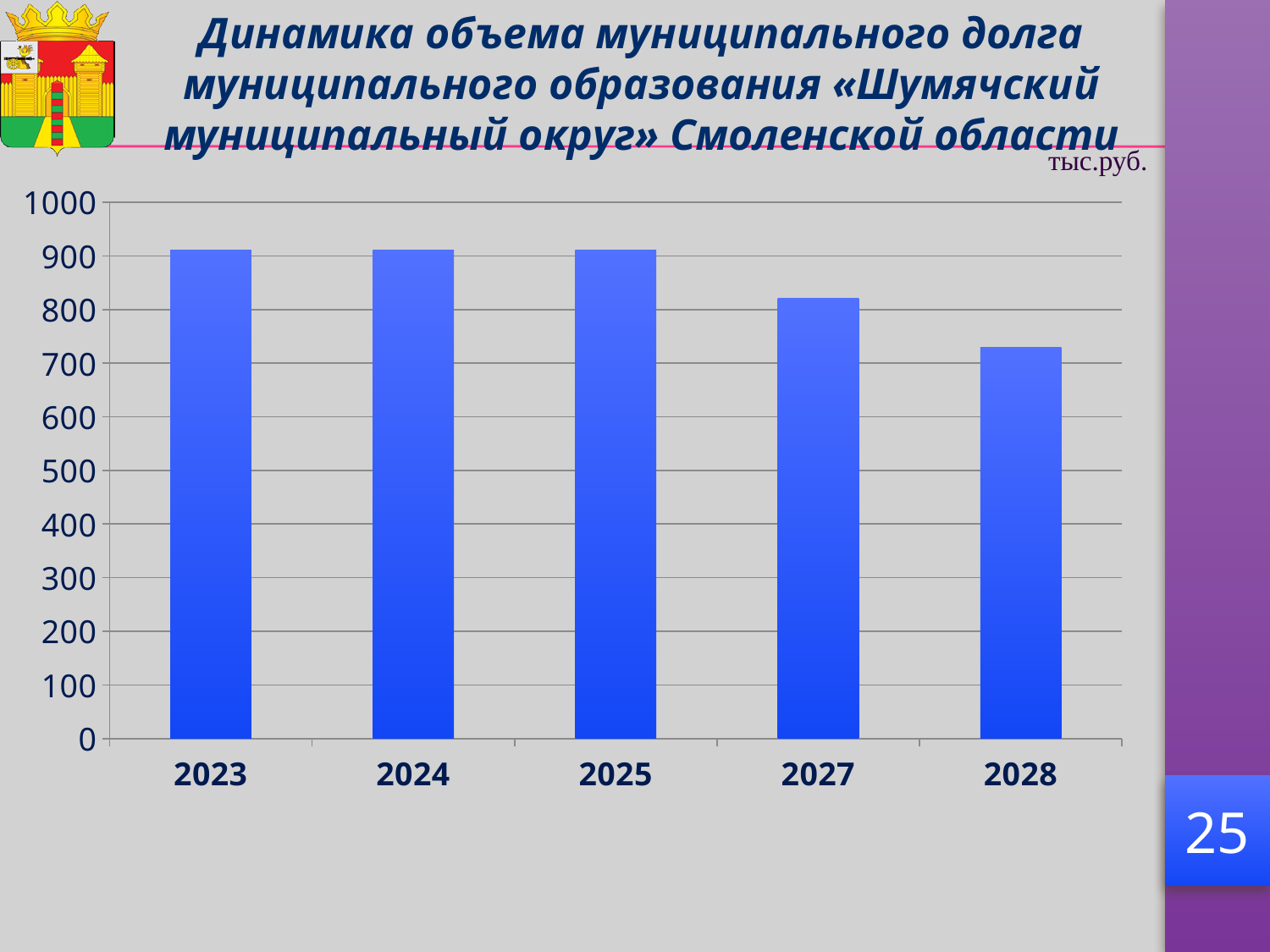
Which is larger, the value for 2024 or the value for 2028? 2024 Is the value for 2027 greater or less than 900? less Do the values rise or fall from 2025 to 2028? fall Which year has the lowest value in the chart? 2028 What kind of chart is shown on the slide? bar chart How many years are shown on the x axis of the chart? 5 What unit of measurement is indicated above the chart? тыс.руб. Is the value for 2028 greater or less than 600? greater Which is larger, the value for 2027 or the value for 2028? 2027 Is the value for 2025 greater or less than 1000? less